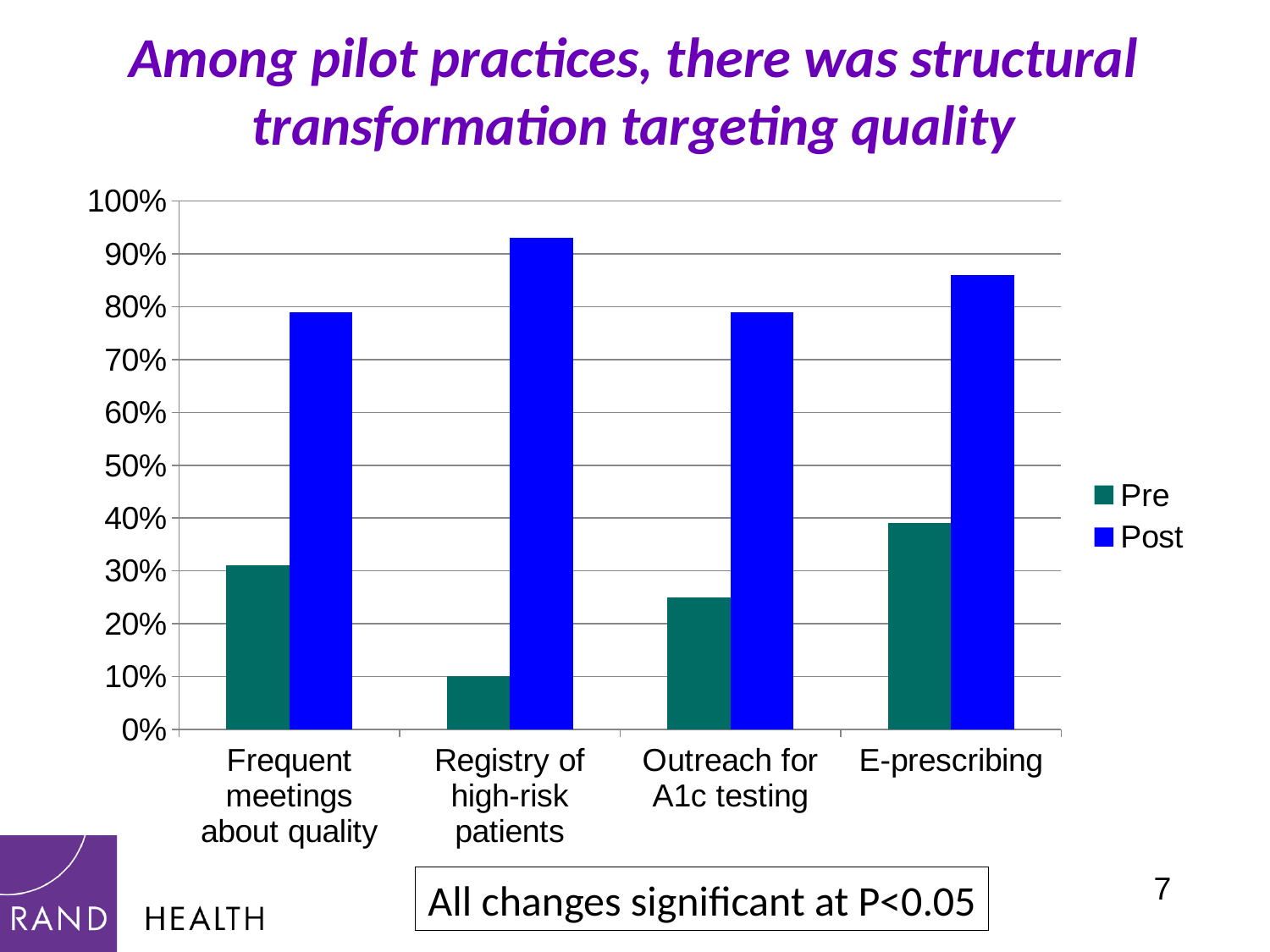
Which category has the highest Pre value? E-prescribing Is the Post value for Registry of high-risk patients greater or less than 90%? greater Which category has the highest Post value? Registry of high-risk patients How many categories are shown on the x axis of the chart? 4 Which category has the lowest Pre value? Registry of high-risk patients Is the Post value for E-prescribing greater or less than 80%? greater Which series is shown in blue in the chart? Post What kind of chart is shown on the slide? bar chart For Outreach for A1c testing, which is larger, the Pre value or the Post value? Post Is the Pre value for Frequent meetings about quality greater or less than 40%? less How many series does the chart's legend list? 2 What does the boxed note below the chart say? All changes significant at P<0.05